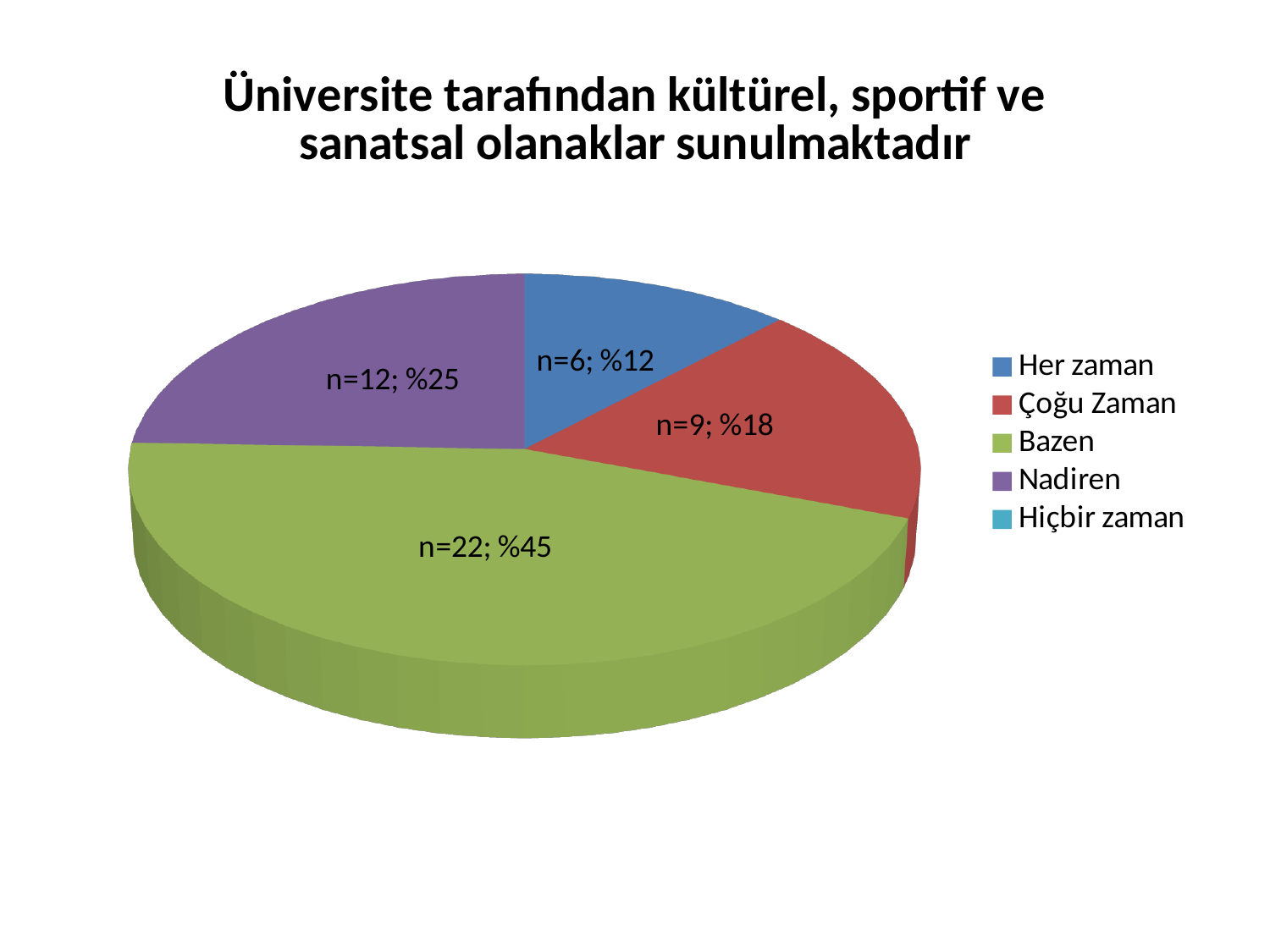
What is the title of the chart? Üniversite tarafından kültürel, sportif ve sanatsal olanaklar sunulmaktadır Which category with a visible slice has the smallest share of the pie? Her zaman What is the data label for the Nadiren slice? n=12; %25 What is the data label for the Bazen slice? n=22; %45 What is the difference in n between the Bazen slice and the Nadiren slice? 10 What percentage share of the pie does the Nadiren slice represent? %25 Which slice is larger, Çoğu Zaman or Her zaman? Çoğu Zaman How many categories does the legend list? 5 Which category has the largest slice of the pie? Bazen What kind of chart is shown on the slide? pie chart What is the data label for the Çoğu Zaman slice? n=9; %18 What is the data label for the Her zaman slice? n=6; %12